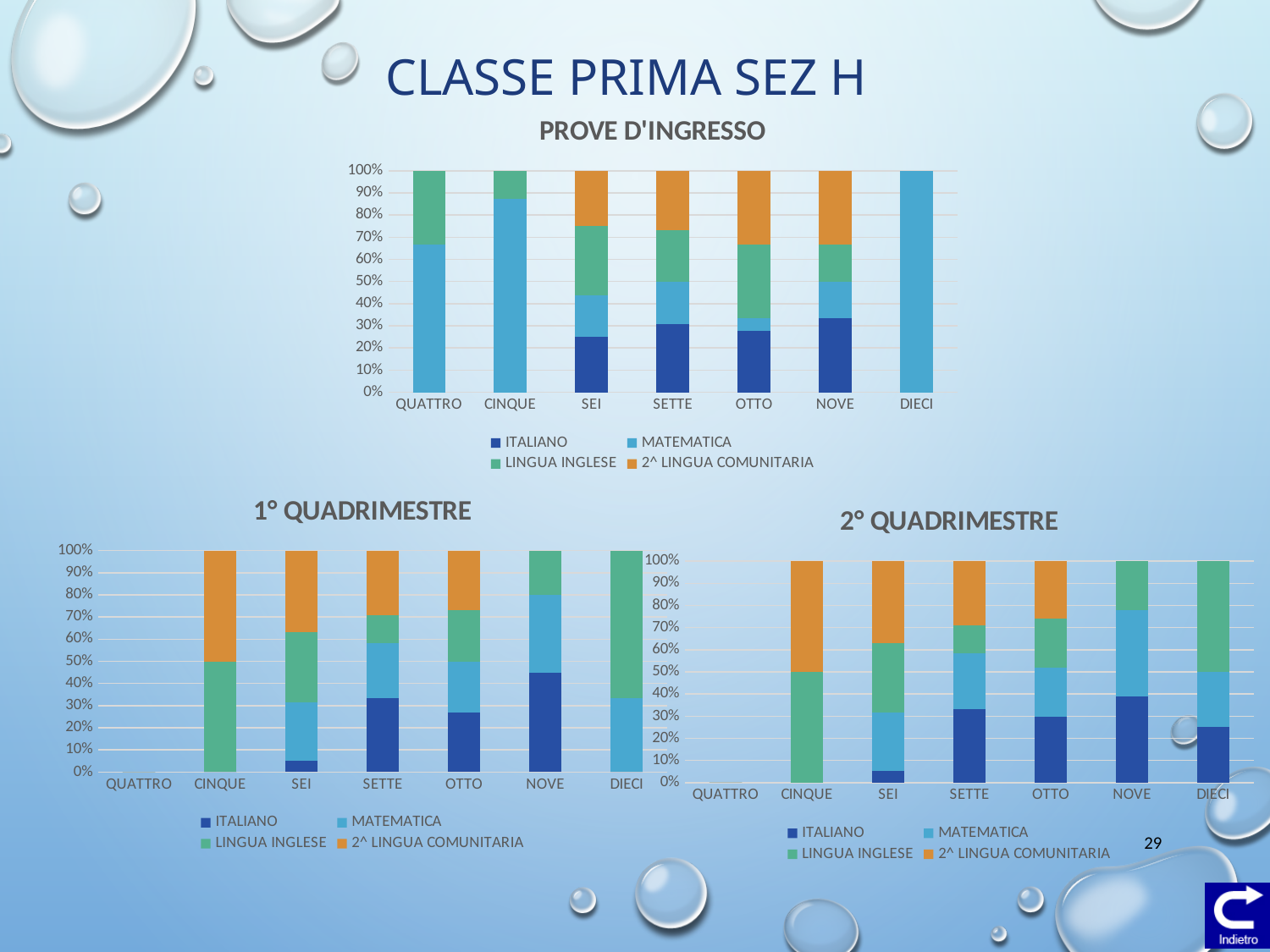
What is the title of the chart at the top of the slide? PROVE D'INGRESSO In the PROVE D'INGRESSO chart, is the value for ITALIANO for SEI greater or less than 40%? less In the 1° QUADRIMESTRE chart, is the value for ITALIANO for NOVE greater or less than 30%? greater In the 1° QUADRIMESTRE chart, is the value for ITALIANO for SEI greater or less than 20%? less How many categories are shown on the x axis of the PROVE D'INGRESSO chart? 7 In the PROVE D'INGRESSO chart, which series is shown in orange? 2^ LINGUA COMUNITARIA What kind of chart is the PROVE D'INGRESSO chart? Stacked bar chart How many series does the legend of the 1° QUADRIMESTRE chart list? 4 In the PROVE D'INGRESSO chart, what is the value for MATEMATICA for DIECI? 100%